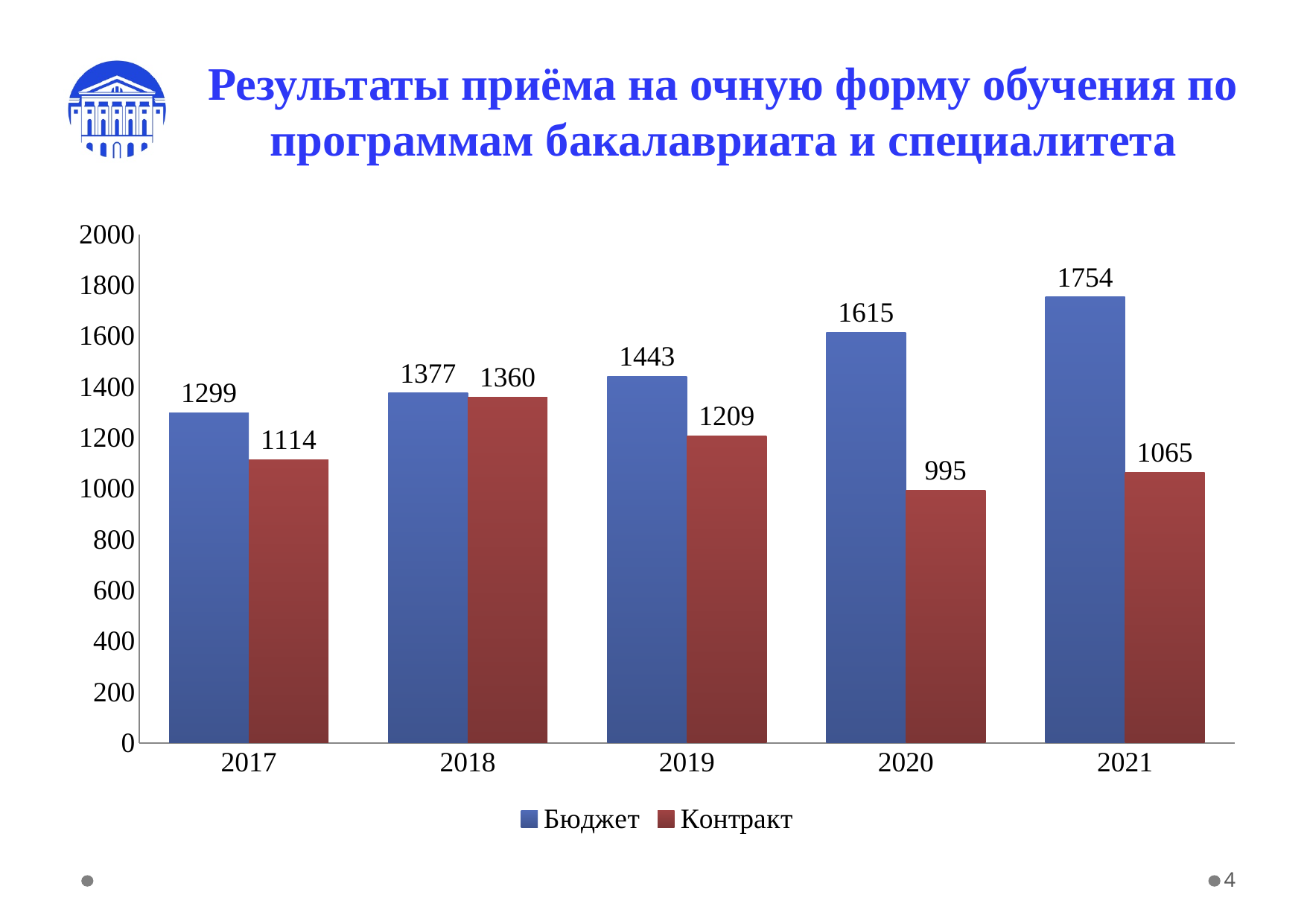
How many series does the legend list? 2 What kind of chart is shown on the slide? bar chart What is the value for Контракт in 2020? 995 How many years are shown on the x axis? 5 What is the value for Бюджет in 2019? 1443 Which is larger in 2017, Бюджет or Контракт? Бюджет What is the value for Контракт in 2018? 1360 In which year is the Контракт value lowest? 2020 In which year is the Бюджет value highest? 2021 Is the value for Бюджет in 2020 greater or less than 1400? greater What is the difference between the Бюджет and Контракт values in 2021? 689 Does the Бюджет series rise or fall from 2017 to 2021? rise